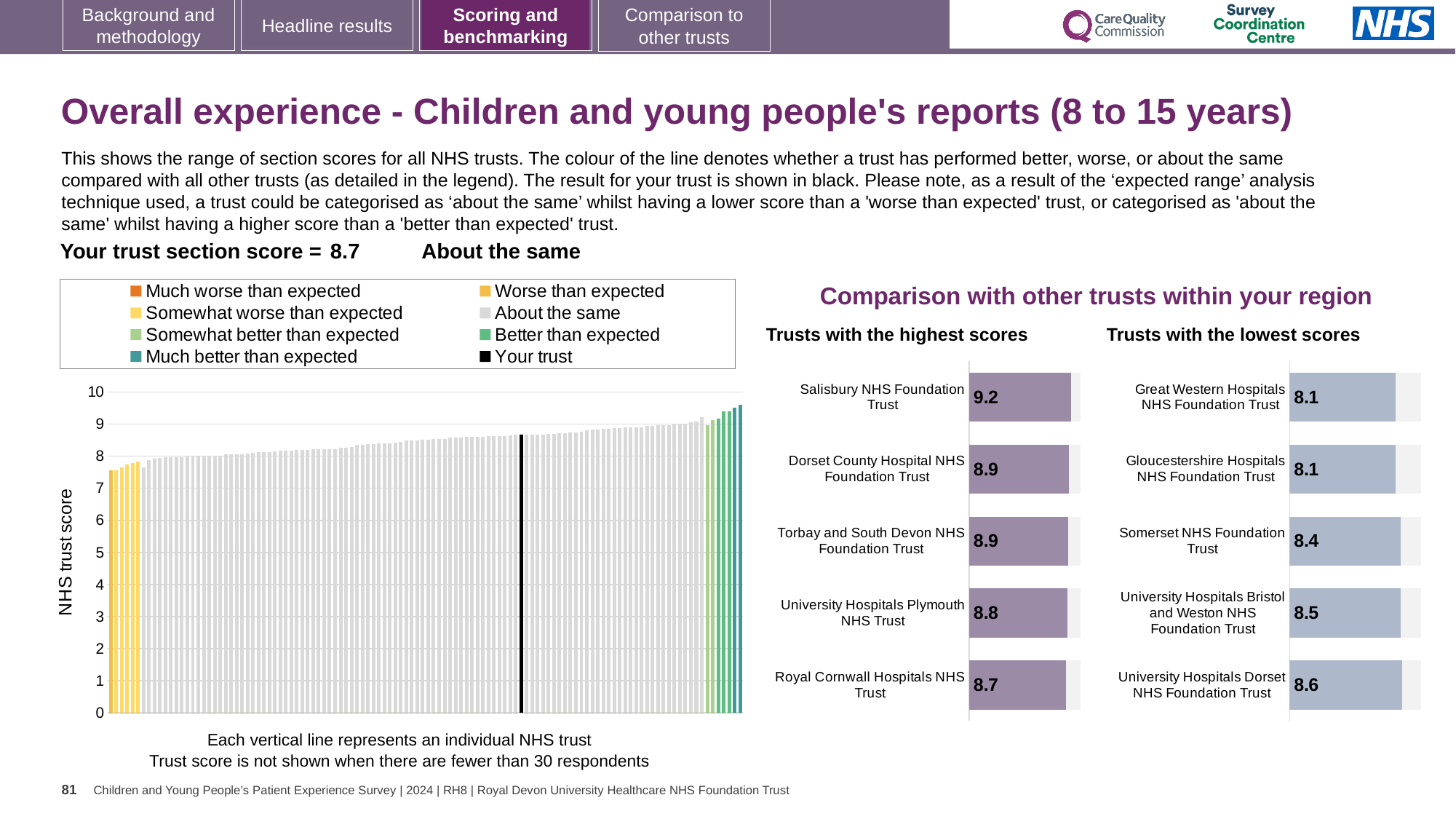
In the large chart on the left, what is the label on the vertical axis? NHS trust score In the 'Trusts with the lowest scores' chart, what is the score for Somerset NHS Foundation Trust? 8.4 In the 'Trusts with the highest scores' chart, what is the difference between the scores of Salisbury NHS Foundation Trust and Royal Cornwall Hospitals NHS Trust? 0.5 In the 'Trusts with the lowest scores' chart, which trust has the highest score? University Hospitals Dorset NHS Foundation Trust What kind of chart is the large chart on the left showing NHS trust scores? Bar chart How many trusts are shown in the 'Trusts with the highest scores' chart? 5 In the 'Trusts with the lowest scores' chart, what is the difference between the scores of University Hospitals Dorset NHS Foundation Trust and Great Western Hospitals NHS Foundation Trust? 0.5 In the 'Trusts with the highest scores' chart, what is the score for Salisbury NHS Foundation Trust? 9.2 How many entries does the legend of the large chart on the left list? 8 In the large chart on the left, do the trust scores rise or fall from left to right along the x axis? Rise In the 'Trusts with the lowest scores' chart, which has the larger score: Somerset NHS Foundation Trust or University Hospitals Bristol and Weston NHS Foundation Trust? University Hospitals Bristol and Weston NHS Foundation Trust In the 'Trusts with the highest scores' chart, which trust has the lowest score? Royal Cornwall Hospitals NHS Trust